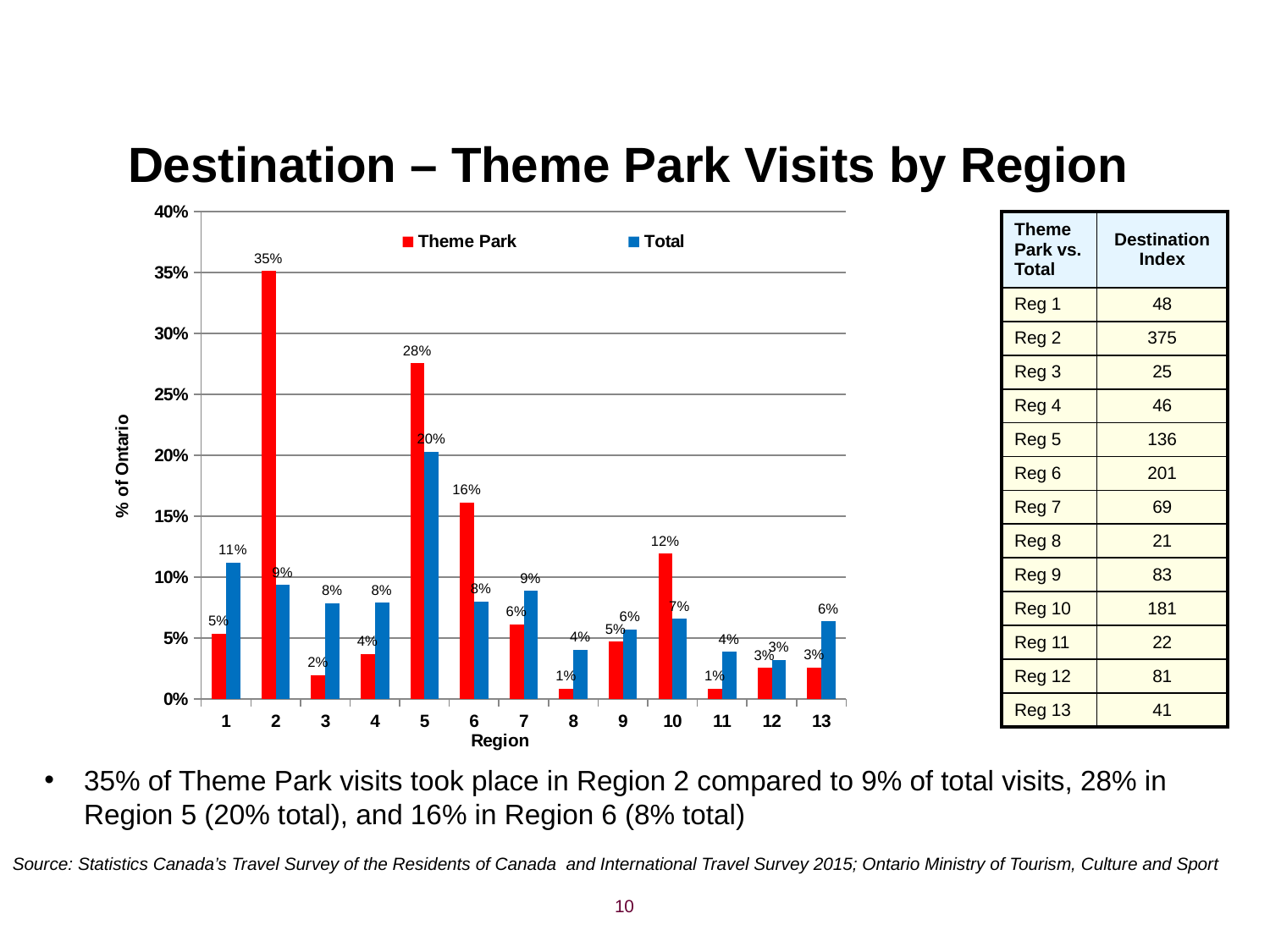
For Region 3, which is larger: the Theme Park value or the Total value? Total What percentage of Theme Park visits took place in Region 2? 35% Which region has the lowest Total value? Region 12 How many regions are shown on the x axis of the chart? 13 What type of chart is shown on the slide? Bar chart What is the difference between the Theme Park and Total values for Region 6? 8% What is the Theme Park value for Region 10? 12% How many series does the chart legend list? 2 Which region has the highest Total value? Region 5 What is the Total value for Region 5? 20% What is the Total value for Region 1? 11% Which region has the highest Theme Park value? Region 2